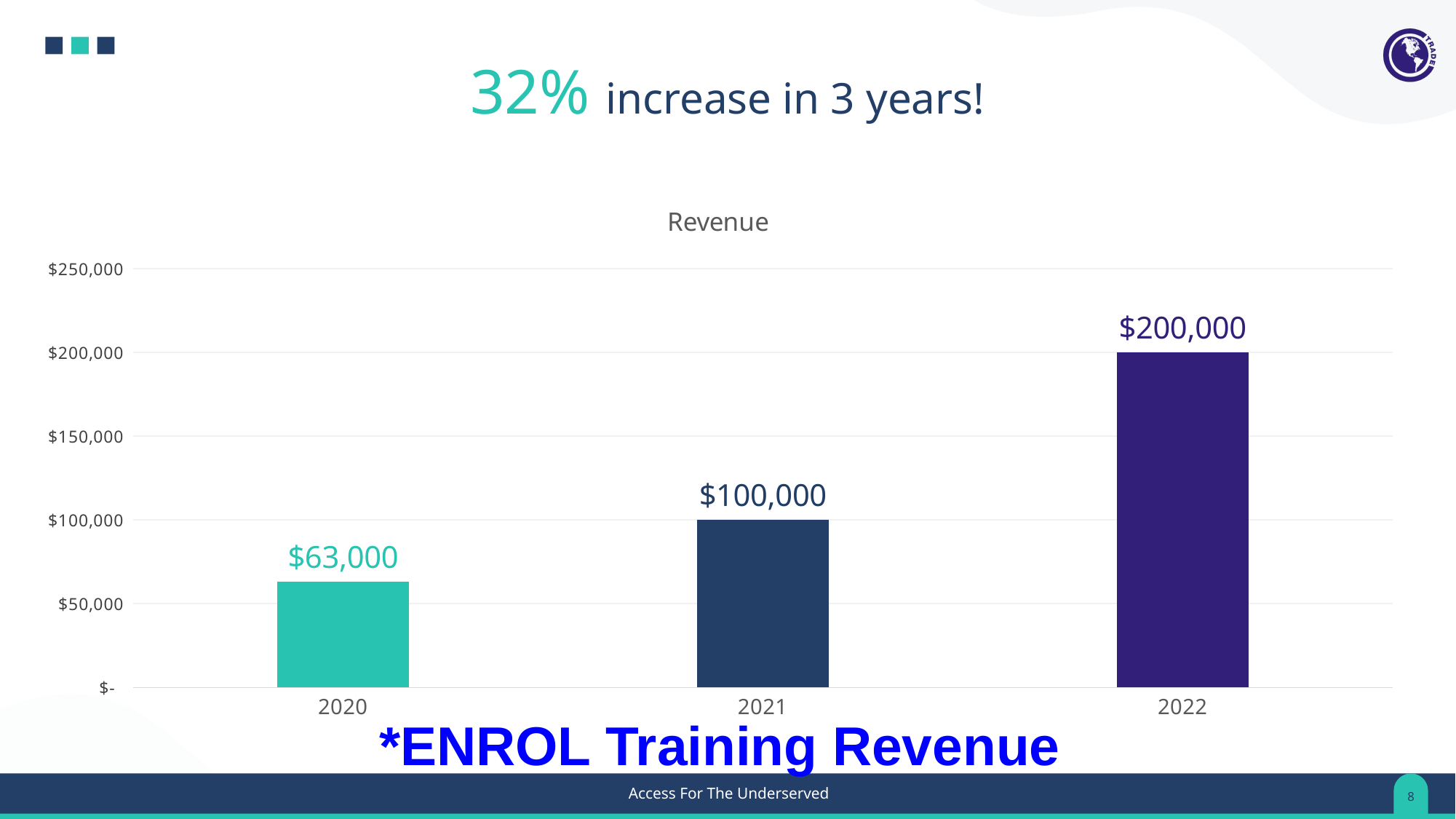
What is the difference in revenue between 2021 and 2020? $37,000 What is the revenue for 2022? $200,000 What kind of chart is shown on the slide? Bar chart What is the title of the chart? Revenue Does revenue rise or fall from 2020 to 2022? Rise Which year has the highest revenue? 2022 Which year has higher revenue, 2020 or 2021? 2021 What is the difference in revenue between 2022 and 2021? $100,000 What is the revenue for 2020? $63,000 Which year has the lowest revenue? 2020 What is the revenue for 2021? $100,000 How many years are shown on the chart? 3